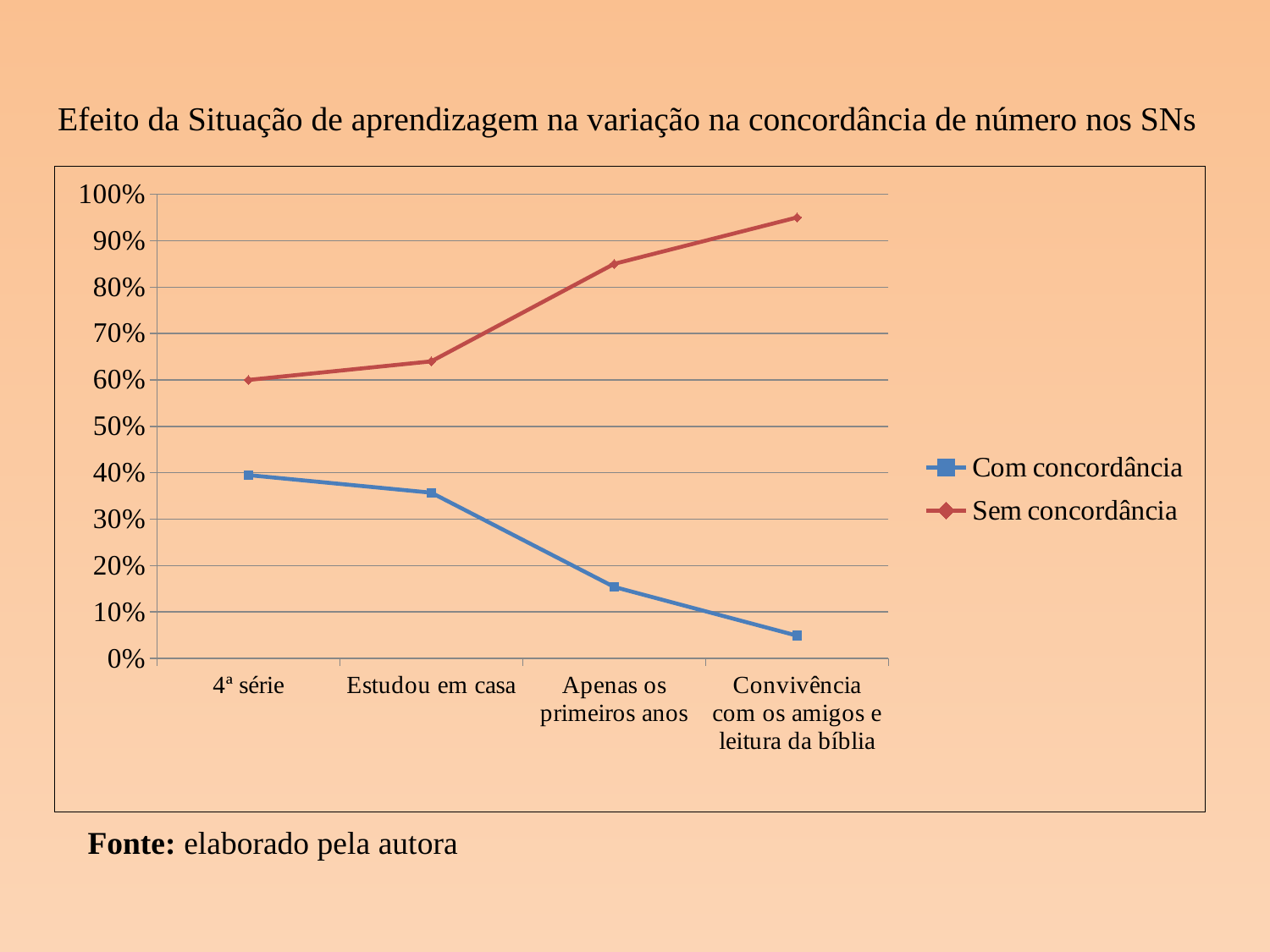
How many series does the legend list? 2 Is the 'Sem concordância' value for 'Apenas os primeiros anos' greater or less than 80%? greater For 'Apenas os primeiros anos', which series has the larger value, 'Com concordância' or 'Sem concordância'? Sem concordância Which category has the lowest 'Com concordância' value? Convivência com os amigos e leitura da bíblia Is the 'Com concordância' value for 'Convivência com os amigos e leitura da bíblia' greater or less than 10%? less Is the 'Sem concordância' value for 'Convivência com os amigos e leitura da bíblia' greater or less than 90%? greater Which category has the highest 'Sem concordância' value? Convivência com os amigos e leitura da bíblia What kind of chart is shown on the slide? line chart How many categories are shown on the x axis? 4 Does the 'Com concordância' series rise or fall across the categories from left to right? fall Does the 'Sem concordância' series rise or fall from '4ª série' to 'Convivência com os amigos e leitura da bíblia'? rise